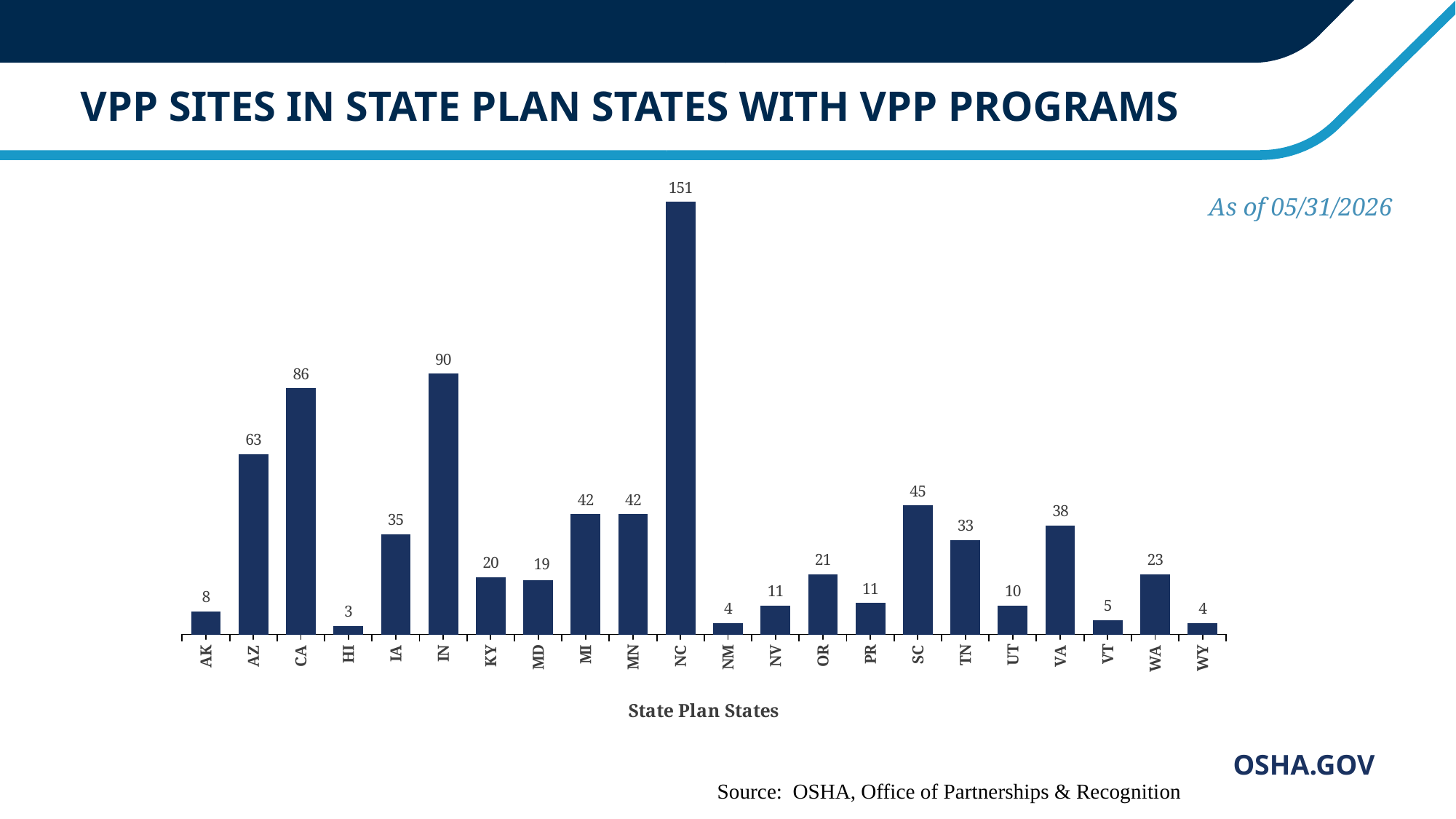
What is the difference between the values for CA and AZ? 23 What is the value shown for VA? 38 Which has a larger value, SC or TN? SC What is the value shown for IN? 90 How many states are shown on the x axis? 22 What is the difference between the values for NC and IN? 61 Which has a larger value, KY or WA? WA What kind of chart is shown on the slide? Bar chart Which state has the lowest number of VPP sites? HI How many VPP sites does NC have? 151 Which state has the highest number of VPP sites? NC What is the x-axis title of the chart? State Plan States